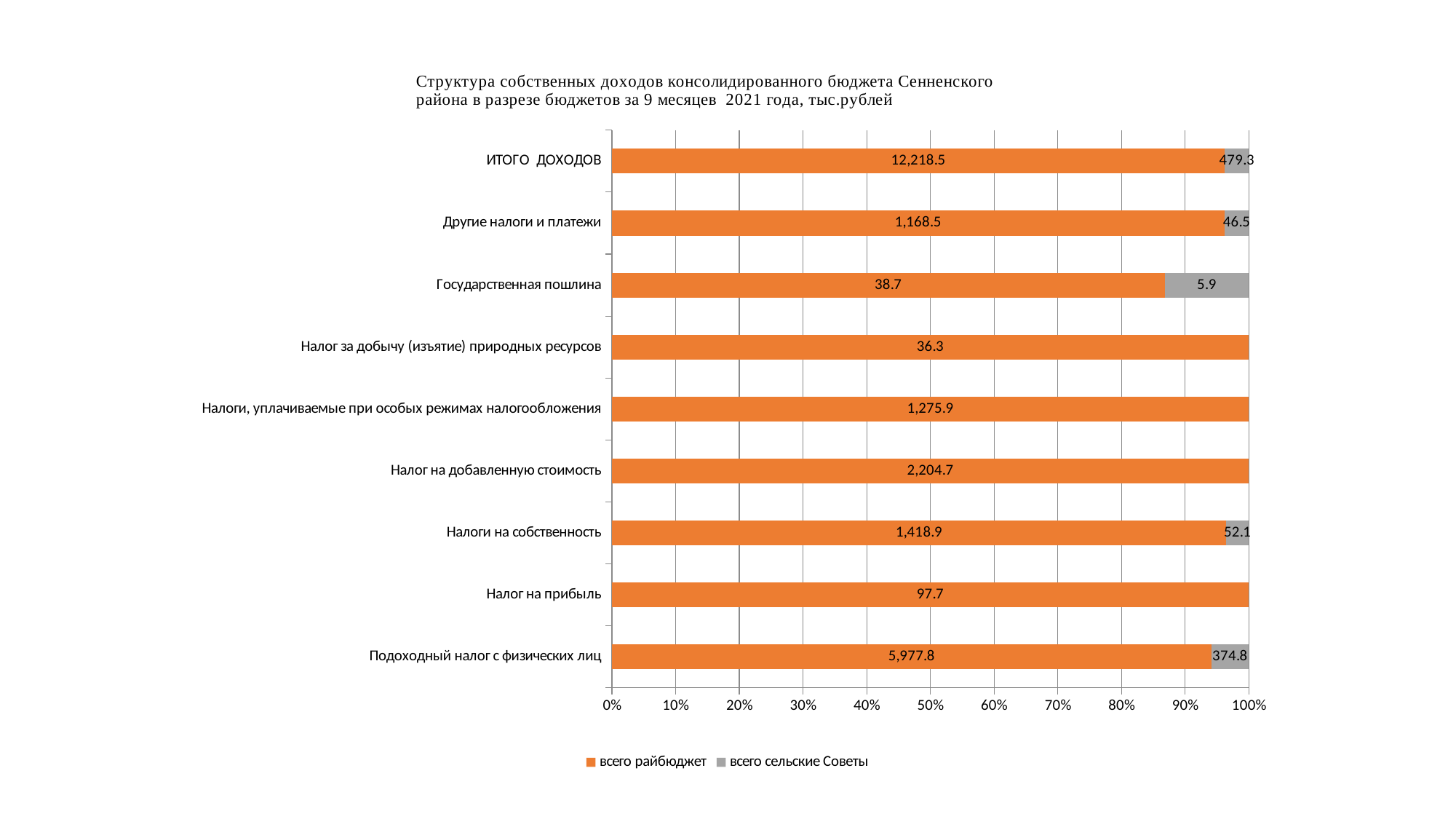
How many series does the legend list? 2 What is the value of всего райбюджет for ИТОГО ДОХОДОВ? 12,218.5 How many categories are shown on the vertical axis? 9 Which is larger: the всего райбюджет value for Налоги на собственность or for Налоги, уплачиваемые при особых режимах налогообложения? Налоги на собственность What is the value of всего сельские Советы for Подоходный налог с физических лиц? 374.8 What is the value of всего райбюджет for Налог на добавленную стоимость? 2,204.7 Is the share of всего райбюджет in the Государственная пошлина bar greater or less than 90%? less Which category has the lowest всего райбюджет value? Налог за добычу (изъятие) природных ресурсов What is the total of the two series for Государственная пошлина? 44.6 What is the difference between the всего сельские Советы values for ИТОГО ДОХОДОВ and Подоходный налог с физических лиц? 104.5 What type of chart is shown on the slide? Stacked bar chart What is the value of всего сельские Советы for Государственная пошлина? 5.9